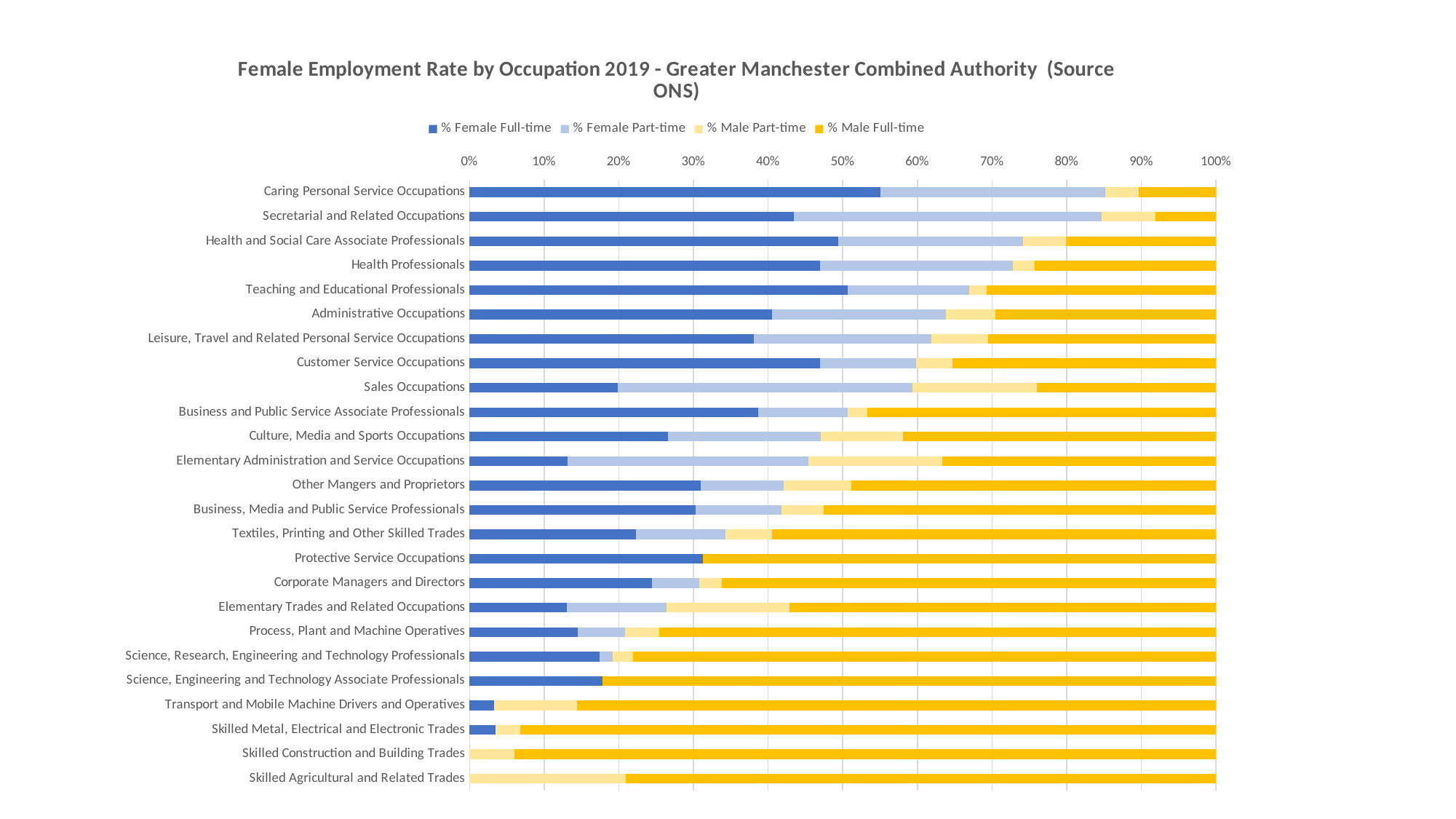
Is the % Female Full-time value for Elementary Administration and Service Occupations greater or less than 20%? less How many occupation categories are plotted on the chart? 25 What kind of chart is shown on the slide? Stacked bar chart Is the % Female Full-time value for Caring Personal Service Occupations greater or less than 50%? greater Which has the larger % Female Full-time share: Caring Personal Service Occupations or Sales Occupations? Caring Personal Service Occupations Which has the larger % Male Full-time share: Skilled Metal, Electrical and Electronic Trades or Secretarial and Related Occupations? Skilled Metal, Electrical and Electronic Trades Which occupation has the highest % Female Full-time share? Caring Personal Service Occupations What is the title of the chart? Female Employment Rate by Occupation 2019 - Greater Manchester Combined Authority (Source ONS) Is the % Female Full-time value for Sales Occupations greater or less than 30%? less How many series does the legend list? 4 Going down the list of occupations from top to bottom, does the % Female Full-time share generally rise or fall? fall